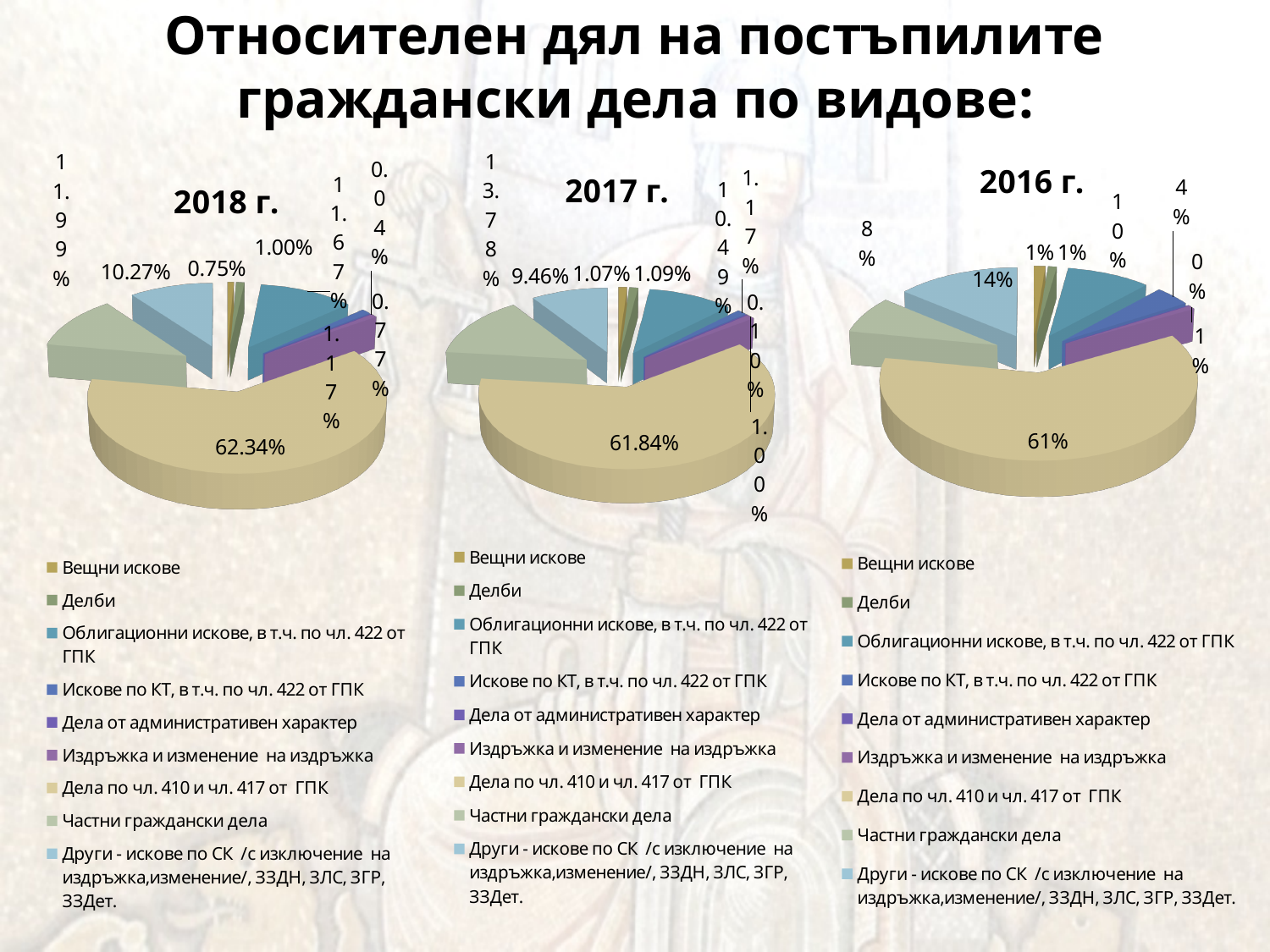
How many entries does the legend of the 2018 г. chart list? 9 In the 2016 г. chart, is the largest slice greater or less than 50%? greater In the 2017 г. chart, what is the share of the largest slice? 61.84% Which legend category corresponds to the largest slice in the 2018 г. chart? Дела по чл. 410 и чл. 417 от ГПК Which year's chart has the highest share for its largest slice? 2018 г. What is the smallest percentage label shown on the 2018 г. chart? 0.04% How many pie charts are shown on the slide? 3 In the 2018 г. chart, what is the share of the largest slice? 62.34% In the 2016 г. chart, what is the share of the largest slice? 61% What is the difference between the largest slice in the 2018 г. chart (62.34%) and the largest slice in the 2017 г. chart (61.84%)? 0.5 percentage points What type of chart is used for the 2018 г. chart? pie chart Which is larger: the largest slice in the 2018 г. chart or the largest slice in the 2017 г. chart? 2018 г. (62.34%)